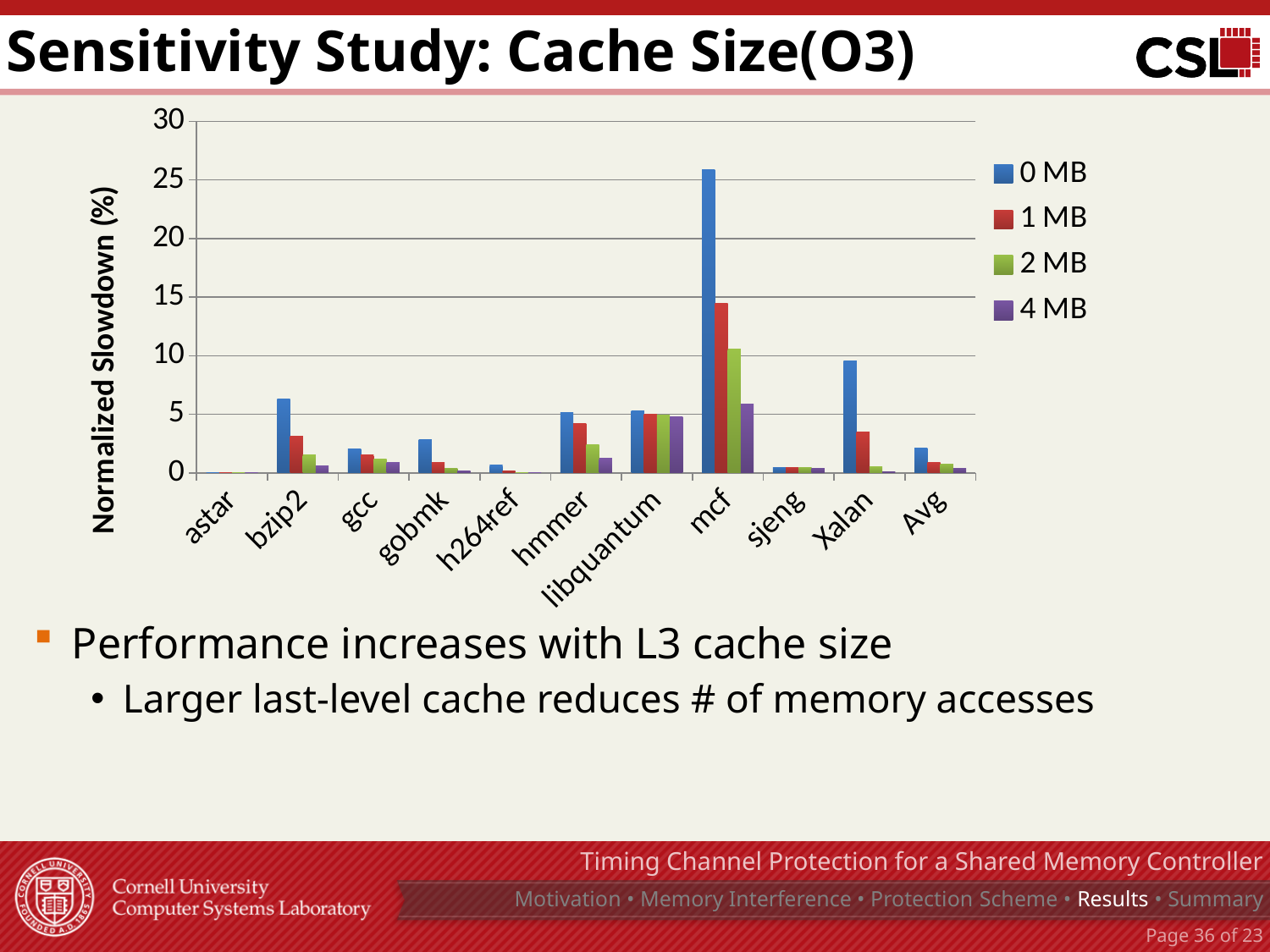
What is the label of the y axis? Normalized Slowdown (%) Which category has the highest value for the 0 MB series? mcf Is the 0 MB value for Xalan greater or less than 5? greater Which is larger for the 0 MB series: mcf or Xalan? mcf Is the 1 MB value for mcf greater or less than 10? greater Is the 0 MB value for mcf greater or less than 20? greater How many benchmark categories are shown on the x axis? 11 Which category has the lowest value for the 0 MB series? astar How many series does the legend list? 4 Which is larger for the 0 MB series: bzip2 or gcc? bzip2 What kind of chart is shown on the slide? bar chart